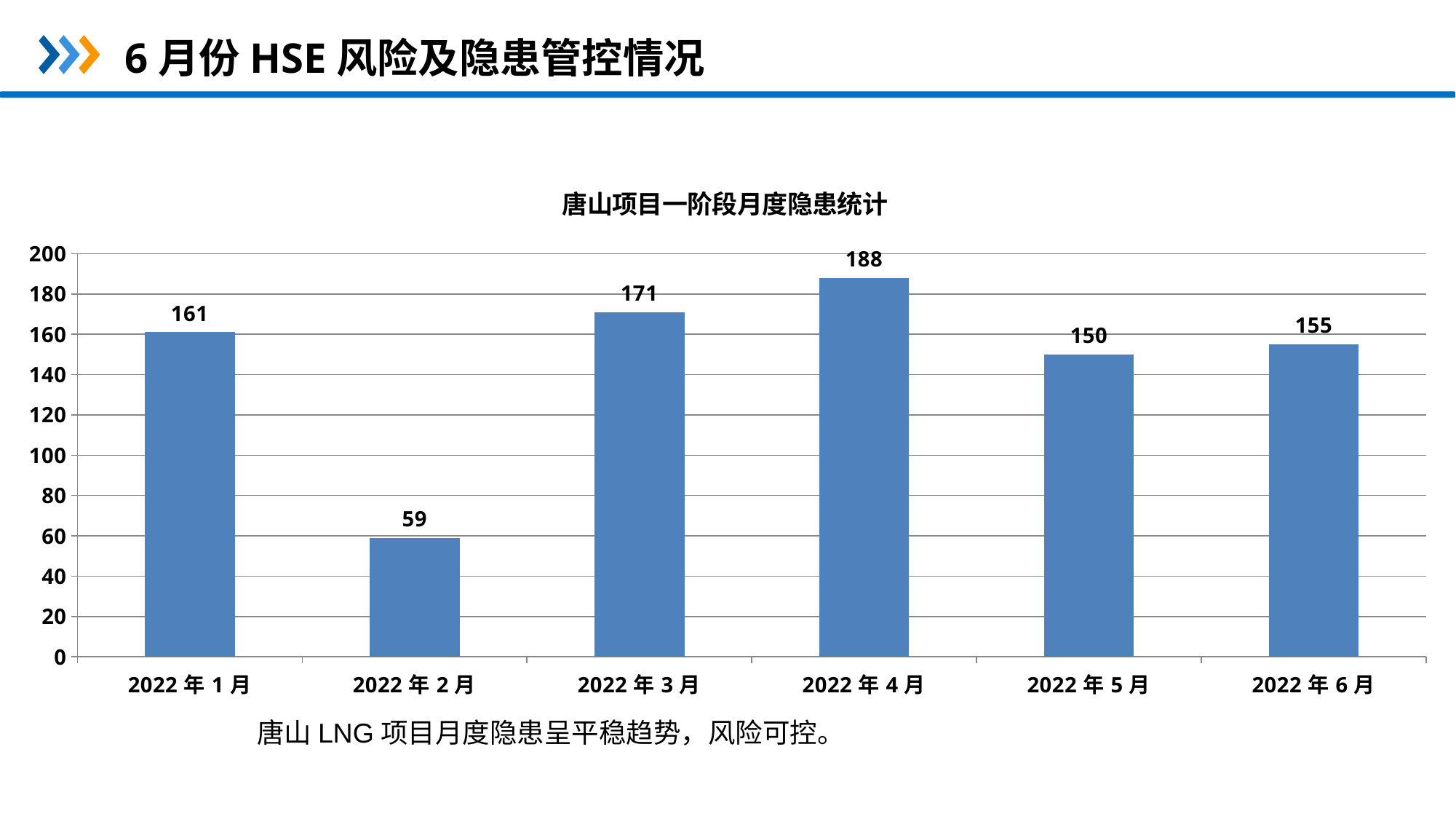
Which is larger, the value for 2022年1月 or the value for 2022年6月? 2022年1月 Which month has the lowest value? 2022年2月 What is the difference between the values for 2022年4月 and 2022年2月? 129 Which month has the highest value? 2022年4月 What kind of chart is shown on the slide? Bar chart What is the difference between the values for 2022年3月 and 2022年5月? 21 What is the value for 2022年6月? 155 What is the title of the chart? 唐山项目一阶段月度隐患统计 What is the value for 2022年4月? 188 What is the value for 2022年1月? 161 What is the value for 2022年2月? 59 How many months are shown on the x axis? 6